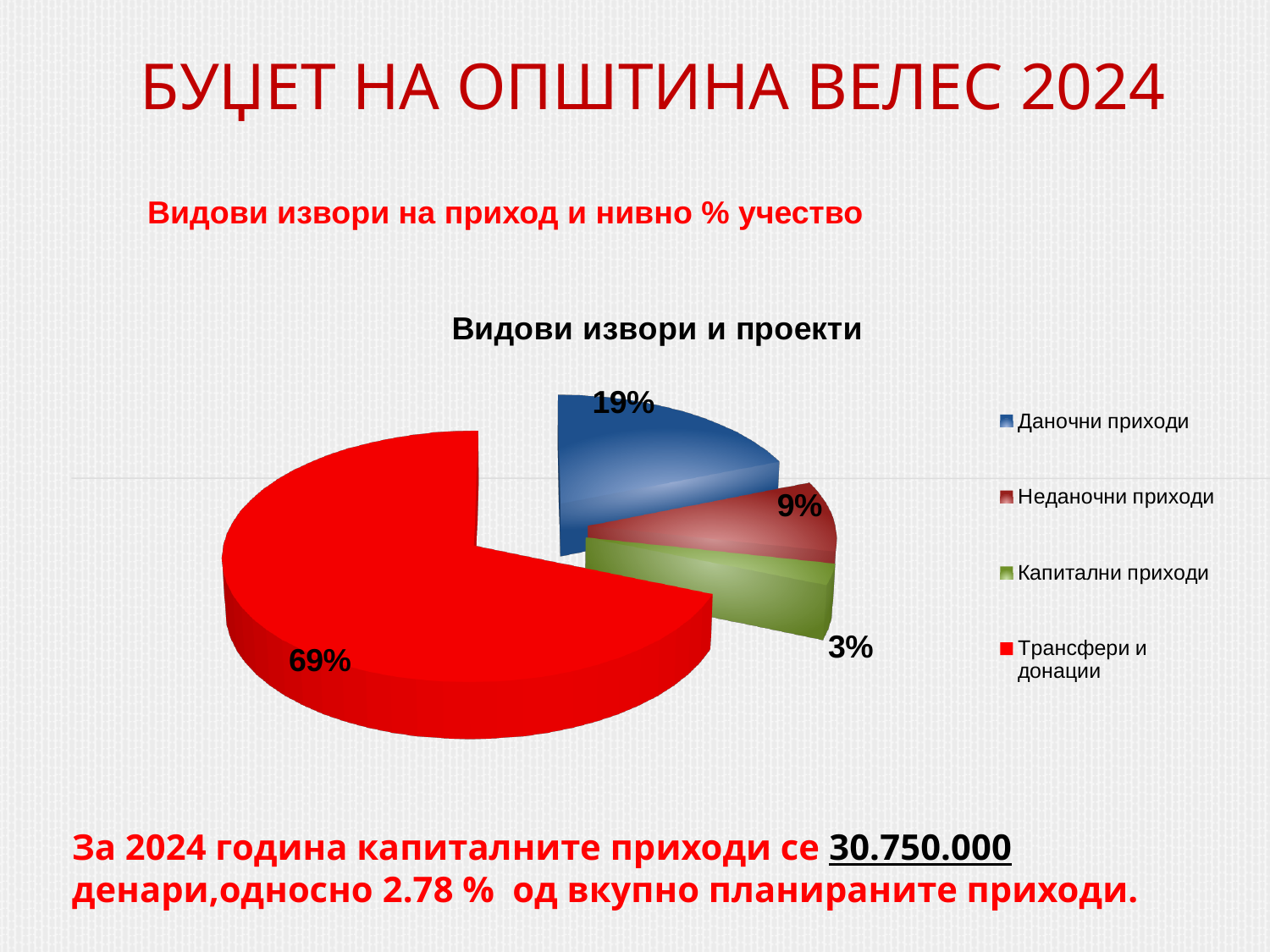
What is the difference in percentage points between Трансфери и донации and Даночни приходи? 50 What percentage share does Неданочни приходи have in the pie chart? 9% Which category has the largest slice in the pie chart? Трансфери и донации What percentage share does Даночни приходи have in the pie chart? 19% What percentage share does Трансфери и донации have in the pie chart? 69% How many categories does the legend of the pie chart list? 4 What kind of chart is shown on the slide? Pie chart Which is larger in the pie chart, Даночни приходи or Неданочни приходи? Даночни приходи What percentage share does Капитални приходи have in the pie chart? 3% Which category has the smallest slice in the pie chart? Капитални приходи What colour is the slice for Капитални приходи in the pie chart? Green What is the title of the chart? Видови извори и проекти